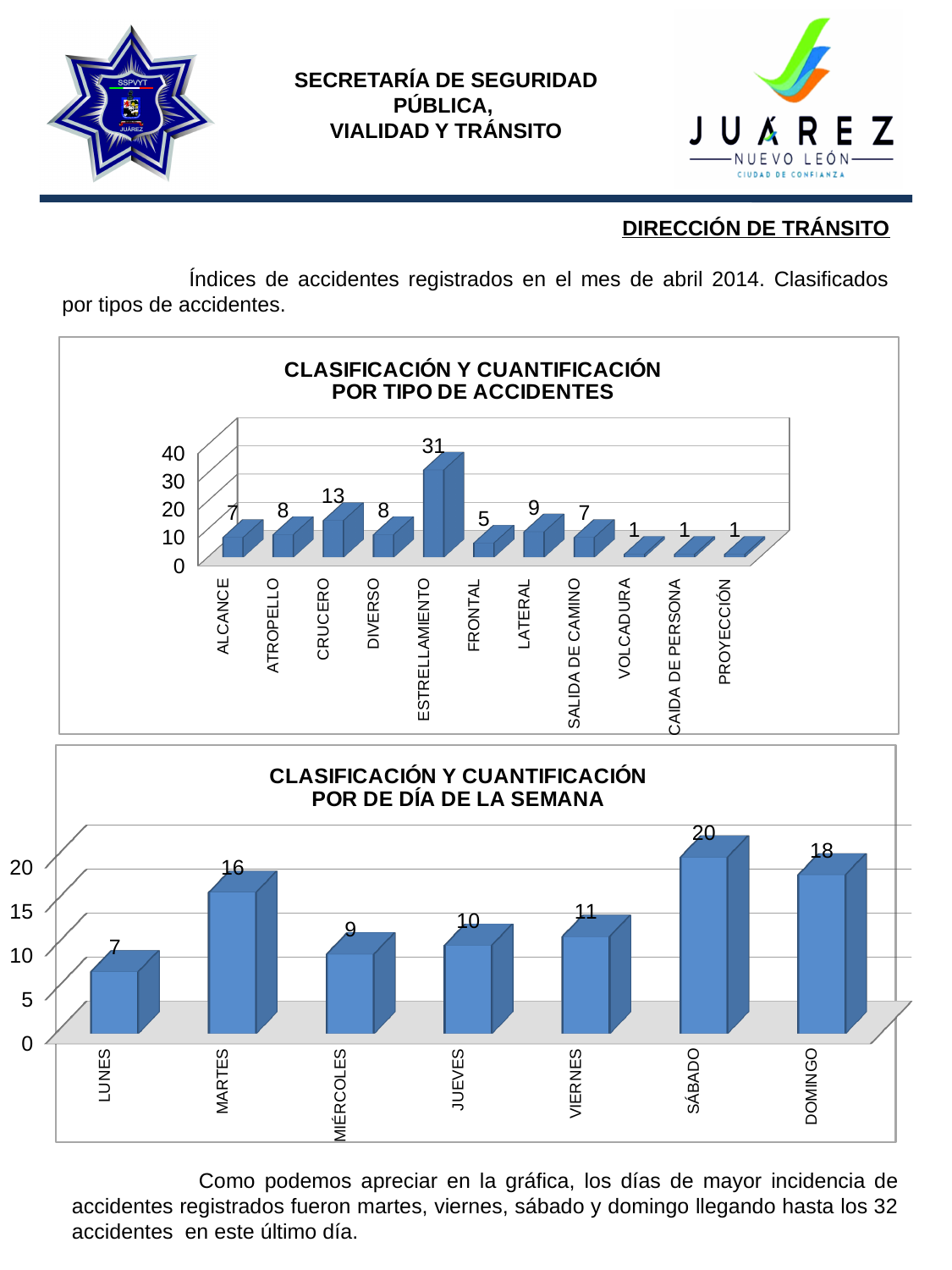
In the 'CLASIFICACIÓN Y CUANTIFICACIÓN POR DE DÍA DE LA SEMANA' chart, what is the difference between the values for SÁBADO and DOMINGO? 2 In the 'CLASIFICACIÓN Y CUANTIFICACIÓN POR DE DÍA DE LA SEMANA' chart, which day has the lowest value? LUNES What kind of chart is the 'CLASIFICACIÓN Y CUANTIFICACIÓN POR DE DÍA DE LA SEMANA' chart? Bar chart In the 'CLASIFICACIÓN Y CUANTIFICACIÓN POR TIPO DE ACCIDENTES' chart, which is larger, the value for LATERAL or the value for FRONTAL? LATERAL In the 'CLASIFICACIÓN Y CUANTIFICACIÓN POR DE DÍA DE LA SEMANA' chart, what is the value for SÁBADO? 20 In the 'CLASIFICACIÓN Y CUANTIFICACIÓN POR TIPO DE ACCIDENTES' chart, which category has the highest value? ESTRELLAMIENTO In the 'CLASIFICACIÓN Y CUANTIFICACIÓN POR DE DÍA DE LA SEMANA' chart, which is larger, the value for MARTES or the value for VIERNES? MARTES In the 'CLASIFICACIÓN Y CUANTIFICACIÓN POR TIPO DE ACCIDENTES' chart, what is the difference between the values for ESTRELLAMIENTO and CRUCERO? 18 In the 'CLASIFICACIÓN Y CUANTIFICACIÓN POR DE DÍA DE LA SEMANA' chart, how many days are shown on the x axis? 7 In the 'CLASIFICACIÓN Y CUANTIFICACIÓN POR TIPO DE ACCIDENTES' chart, what is the value for CRUCERO? 13 In the 'CLASIFICACIÓN Y CUANTIFICACIÓN POR TIPO DE ACCIDENTES' chart, how many categories are shown on the x axis? 11 In the 'CLASIFICACIÓN Y CUANTIFICACIÓN POR TIPO DE ACCIDENTES' chart, what is the value for ESTRELLAMIENTO? 31